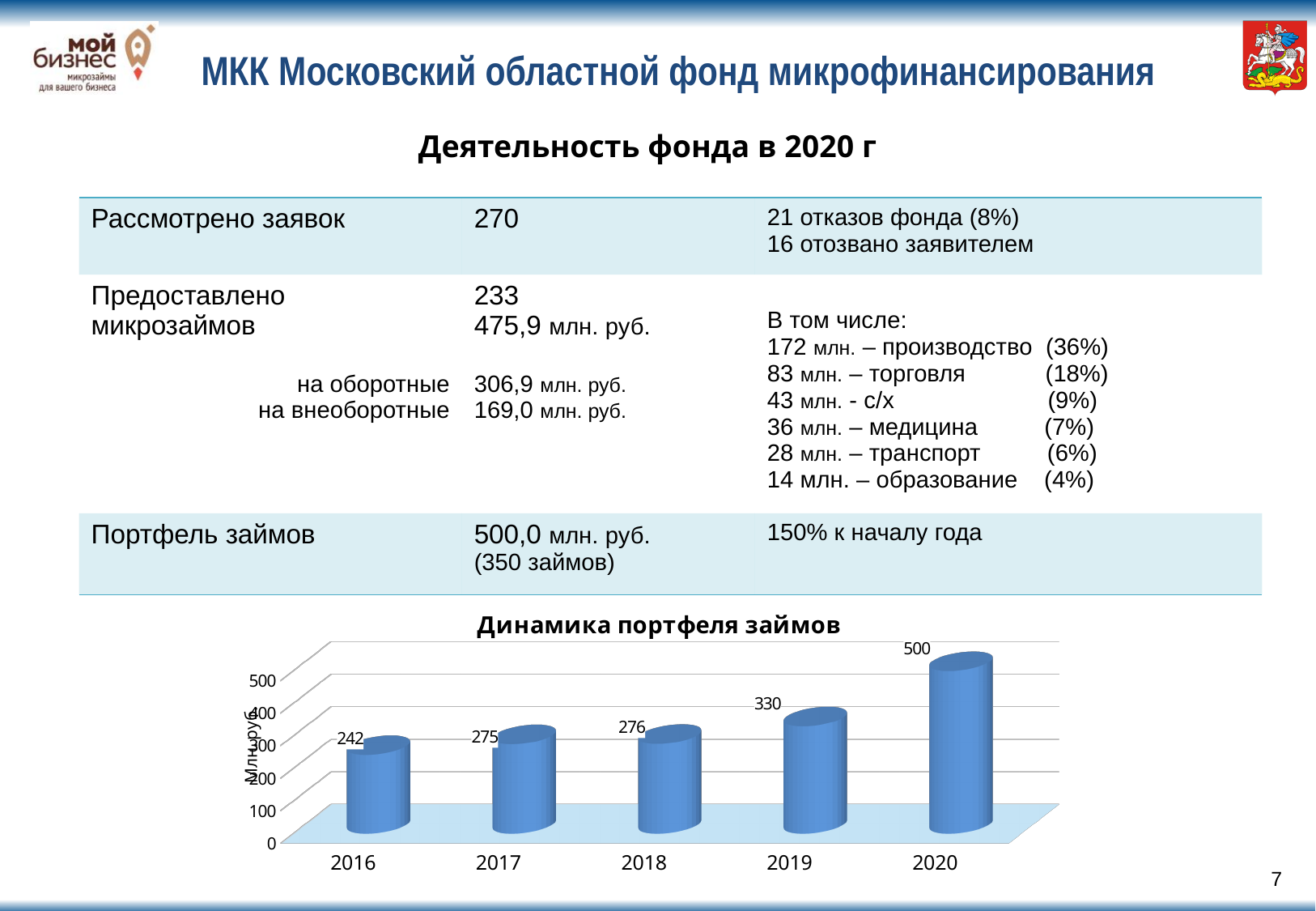
What is the value for 2016 in the 'Динамика портфеля займов' chart? 242 What is the difference between the 2017 and 2016 values in the 'Динамика портфеля займов' chart? 33 Which year has the highest value in the 'Динамика портфеля займов' chart? 2020 Which is larger in the 'Динамика портфеля займов' chart, the value for 2019 or the value for 2017? 2019 What is the value for 2019 in the 'Динамика портфеля займов' chart? 330 What is the value for 2018 in the 'Динамика портфеля займов' chart? 276 What kind of chart is 'Динамика портфеля займов'? bar chart What is the difference between the 2020 and 2019 values in the 'Динамика портфеля займов' chart? 170 How many years are shown on the x axis of the 'Динамика портфеля займов' chart? 5 Do the values in the 'Динамика портфеля займов' chart rise or fall from 2016 to 2020? rise Is the value for 2020 in the 'Динамика портфеля займов' chart greater or less than 400? greater Which year has the lowest value in the 'Динамика портфеля займов' chart? 2016